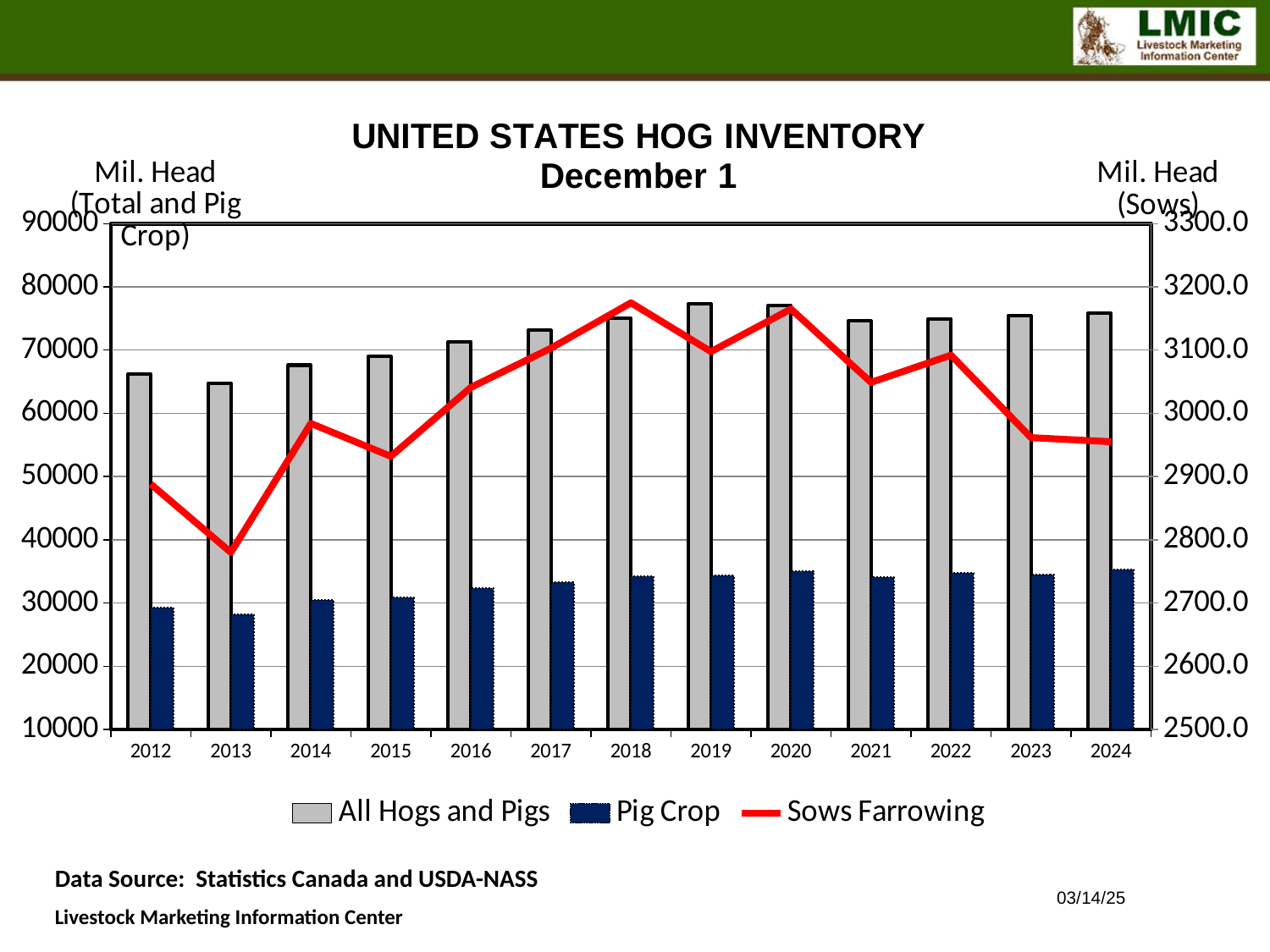
Which year has the lowest value for Sows Farrowing? 2013 Is the Sows Farrowing value for 2018 greater or less than 3100.0? greater Does the Sows Farrowing line rise or fall from 2020 to 2024? fall How many series does the legend list? 3 What kind of chart is shown on the slide? A combination bar and line chart Which year has the larger All Hogs and Pigs value, 2013 or 2018? 2018 Is the All Hogs and Pigs value for 2012 greater or less than 70000? less Which year has the lowest value for All Hogs and Pigs? 2013 Which series is drawn as a red line? Sows Farrowing How many years are shown along the x axis of the chart? 13 What is the title of the chart? UNITED STATES HOG INVENTORY December 1 Is the Pig Crop value for 2024 greater or less than 30000? greater